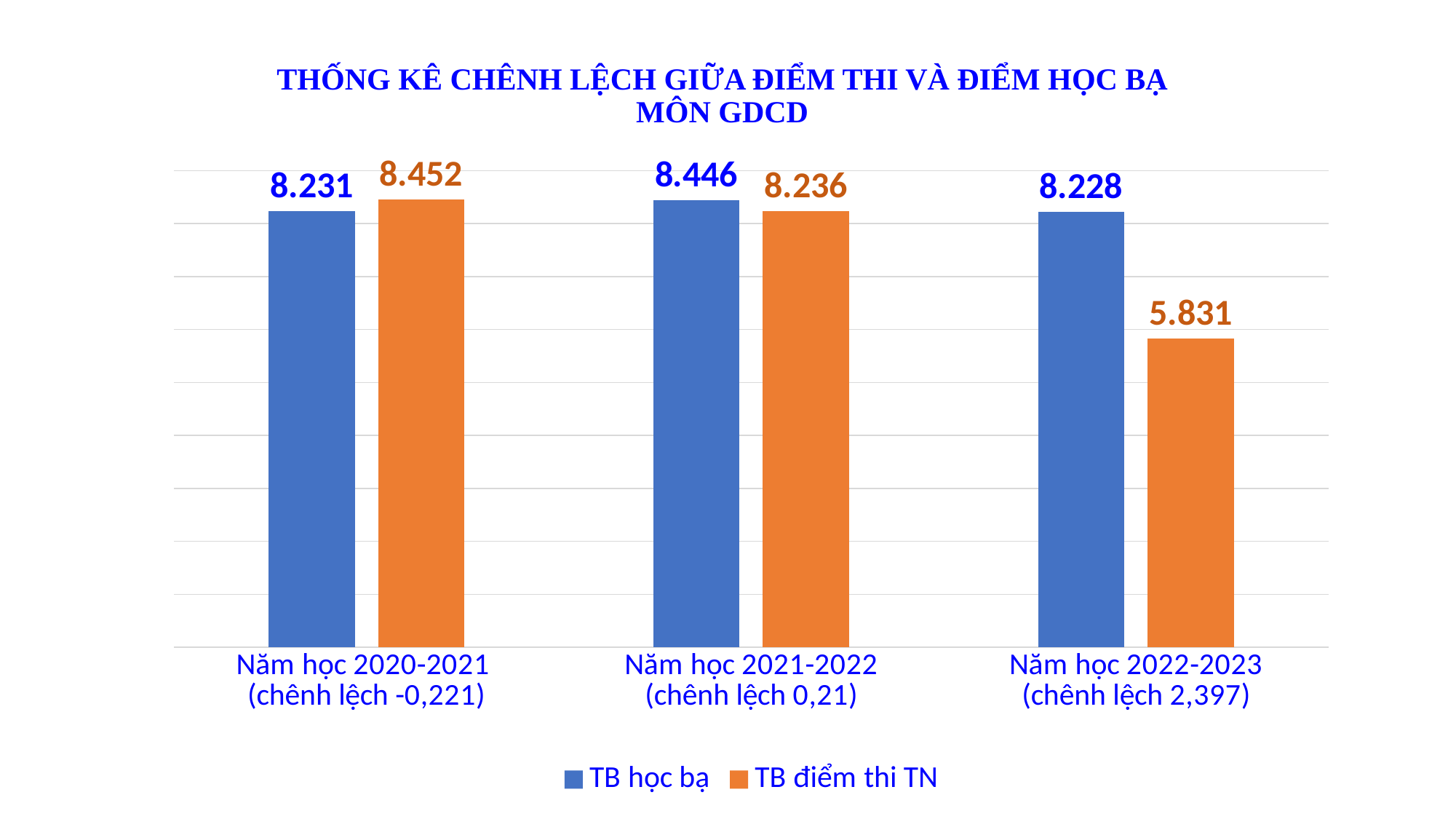
How many series does the legend list? 2 What is the TB học bạ value for Năm học 2021-2022? 8.446 What is the TB điểm thi TN value for Năm học 2021-2022? 8.236 What is the TB học bạ value for Năm học 2020-2021? 8.231 In which school year is the TB điểm thi TN value the lowest? Năm học 2022-2023 What is the difference between TB học bạ and TB điểm thi TN for Năm học 2022-2023? 2.397 For Năm học 2020-2021, which is larger: TB học bạ or TB điểm thi TN? TB điểm thi TN What type of chart is shown on the slide? Bar chart How many school years (categories) are shown on the x axis? 3 What is the TB điểm thi TN value for Năm học 2022-2023? 5.831 Does the TB điểm thi TN value rise or fall from Năm học 2020-2021 to Năm học 2022-2023? Fall In which school year is the TB điểm thi TN value the highest? Năm học 2020-2021